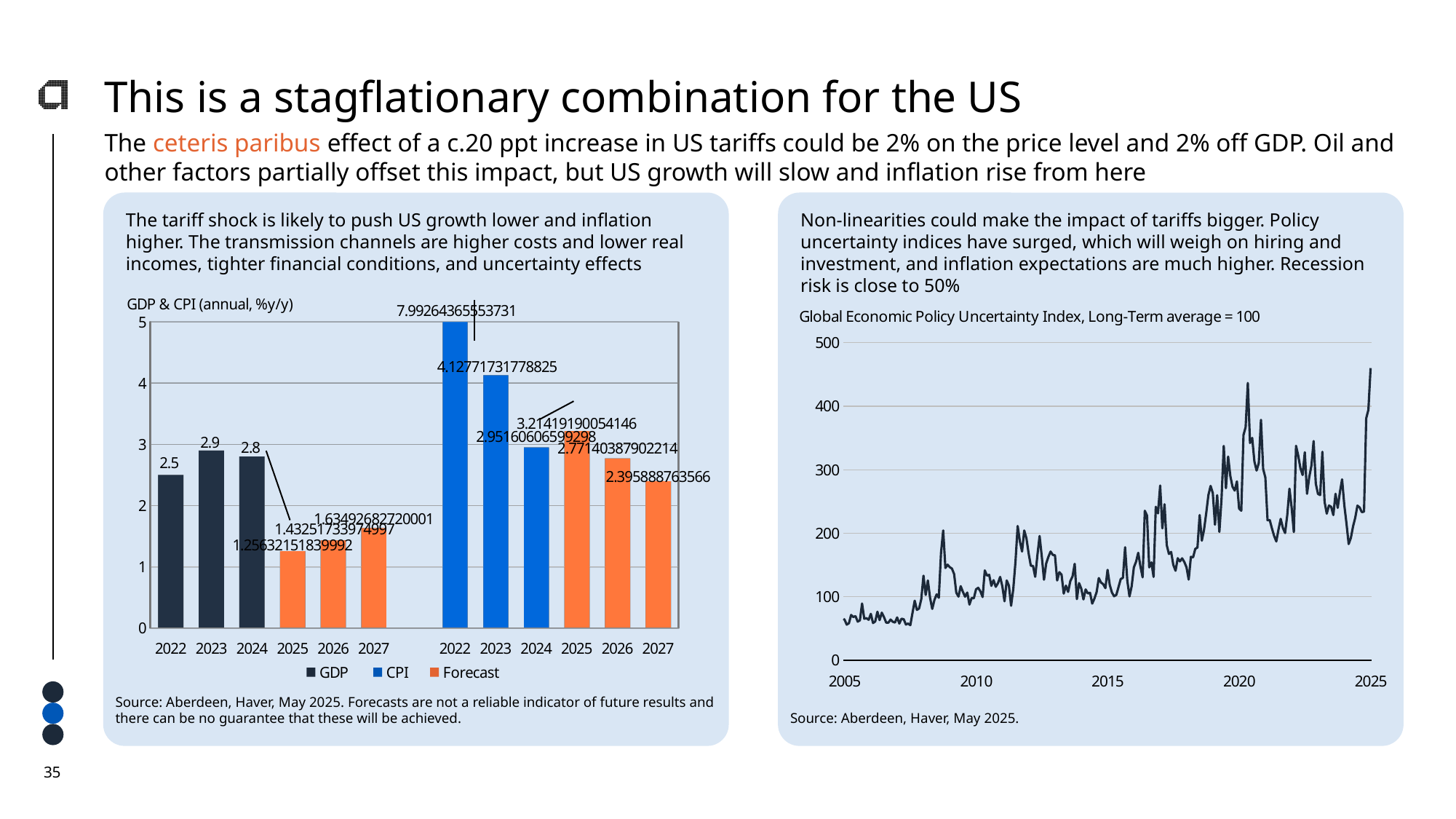
On the GDP & CPI chart, what is the GDP value for 2023? 2.9 What kind of chart is the GDP & CPI chart? Bar chart On the GDP & CPI chart, what is the GDP value for 2022? 2.5 On the GDP & CPI chart, how many series does the legend list? 3 What kind of chart is the Global Economic Policy Uncertainty Index chart? Line chart On the GDP & CPI chart, what is the CPI value for 2022? 7.99264365553731 On the GDP & CPI chart, which year has the highest CPI value? 2022 On the GDP & CPI chart, which is larger: the GDP value for 2023 or the GDP value for 2024? 2023 On the Global Economic Policy Uncertainty Index chart, is the value at the end of the series in 2025 greater or less than 400? greater On the GDP & CPI chart, what is the difference between the GDP values for 2023 and 2022? 0.4 On the GDP & CPI chart, what is the CPI value for 2027? 2.395888763566 On the Global Economic Policy Uncertainty Index chart, is the value at the start of 2005 greater or less than 100? less